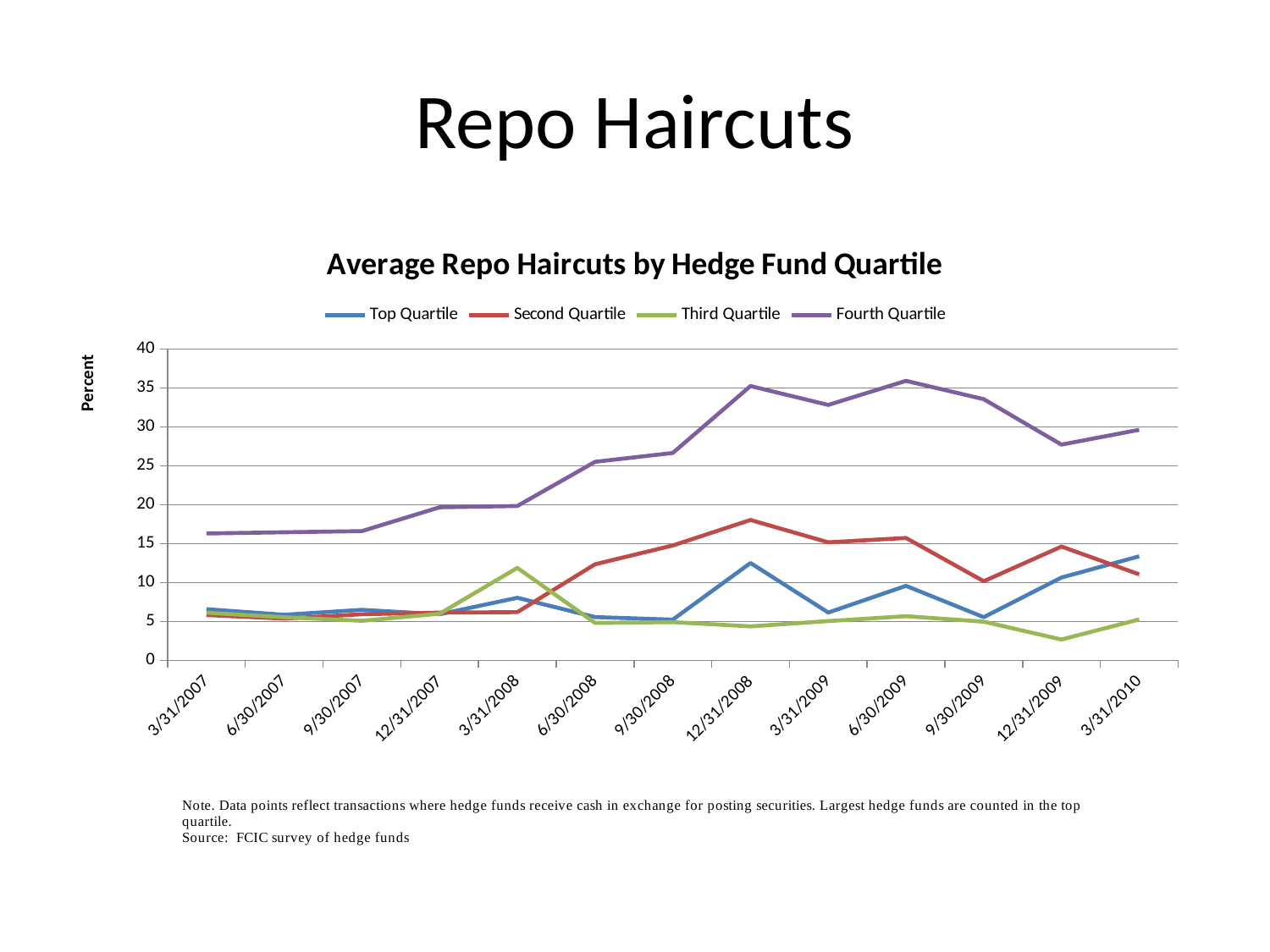
Which series has the lowest value at 12/31/2009? Third Quartile What is the label on the y axis? Percent How many series does the legend list? 4 What kind of chart is shown on the slide? line chart Does the Fourth Quartile line rise or fall from 3/31/2007 to 12/31/2008? rise Is the value for Fourth Quartile at 3/31/2007 greater or less than 20? less Which series has the highest value at 6/30/2009? Fourth Quartile Is the value for Second Quartile at 12/31/2008 greater or less than 15? greater Is the value for Third Quartile at 12/31/2009 greater or less than 5? less How many dates are shown along the x axis? 13 At 12/31/2008, which is larger: Fourth Quartile or Second Quartile? Fourth Quartile